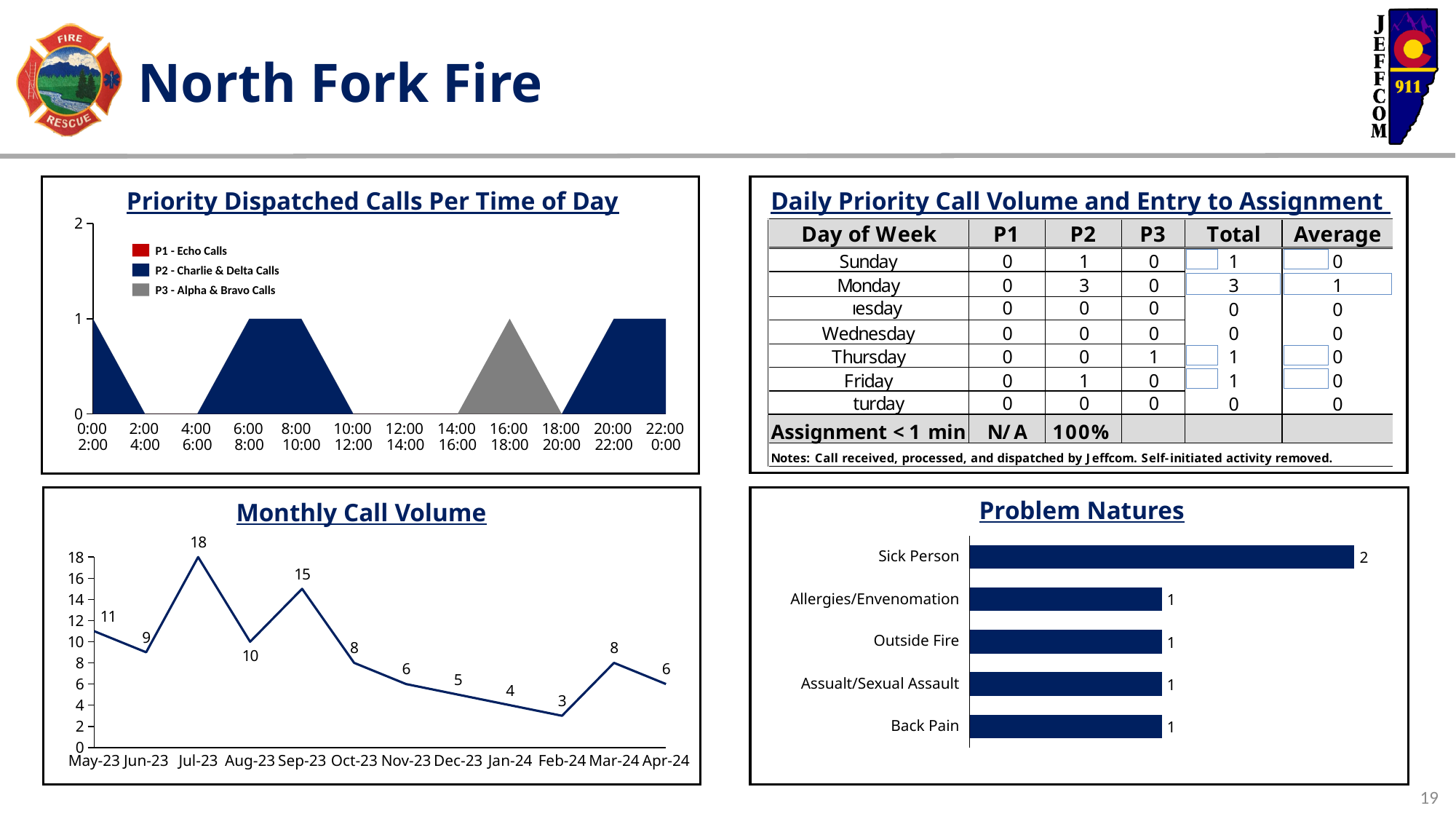
In the Monthly Call Volume chart, what is the value for Jul-23? 18 What kind of chart is the Problem Natures chart? bar chart In the Priority Dispatched Calls Per Time of Day chart, which series is shown in gray? P3 - Alpha & Bravo Calls In the Monthly Call Volume chart, what is the difference between the values for Sep-23 and Oct-23? 7 How many categories are shown in the Problem Natures chart? 5 In the Problem Natures chart, what is the value for Sick Person? 2 In the Monthly Call Volume chart, which month has the highest call volume? Jul-23 In the Monthly Call Volume chart, do the values rise or fall from Oct-23 to Feb-24? fall How many months are plotted in the Monthly Call Volume chart? 12 How many series does the legend of the Priority Dispatched Calls Per Time of Day chart list? 3 In the Monthly Call Volume chart, which is larger, the value for May-23 or the value for Aug-23? May-23 In the Monthly Call Volume chart, which month has the lowest call volume? Feb-24